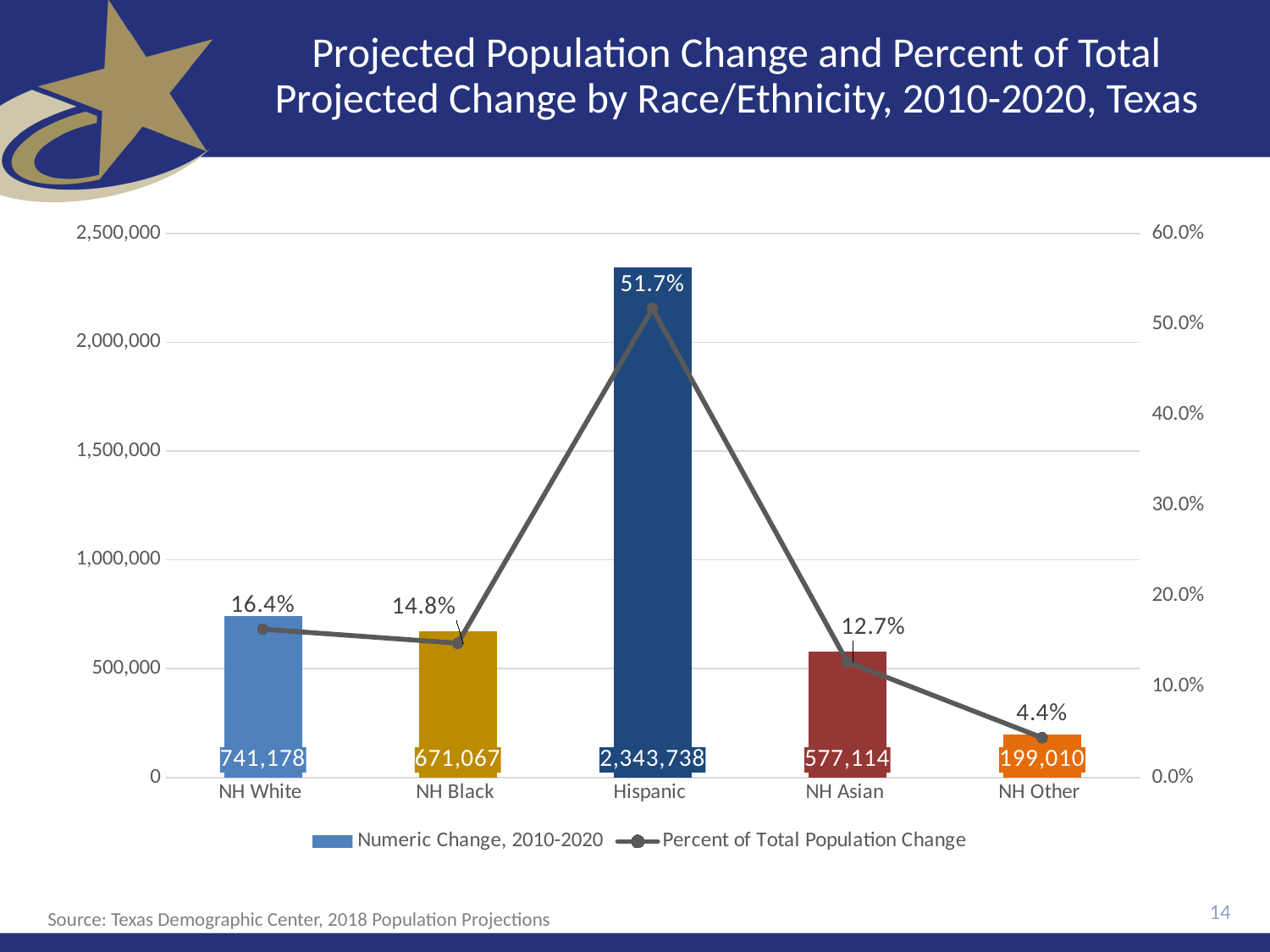
What is the Numeric Change, 2010-2020 for NH Other? 199,010 What is the Numeric Change, 2010-2020 for Hispanic? 2,343,738 How many race/ethnicity categories are shown on the x axis? 5 What is the difference in Numeric Change, 2010-2020 between NH White and NH Black? 70,111 What is the Percent of Total Population Change for NH Asian? 12.7% Which race/ethnicity category has the highest Numeric Change, 2010-2020? Hispanic How many series does the legend list? 2 What is the source cited at the bottom of the slide? Texas Demographic Center, 2018 Population Projections Which race/ethnicity category has the lowest Percent of Total Population Change? NH Other What kind of chart is used to show the Numeric Change, 2010-2020 series? Bar chart Is the Numeric Change, 2010-2020 for NH White greater or less than 500,000? greater Which has a larger Numeric Change, 2010-2020: NH Black or NH Asian? NH Black